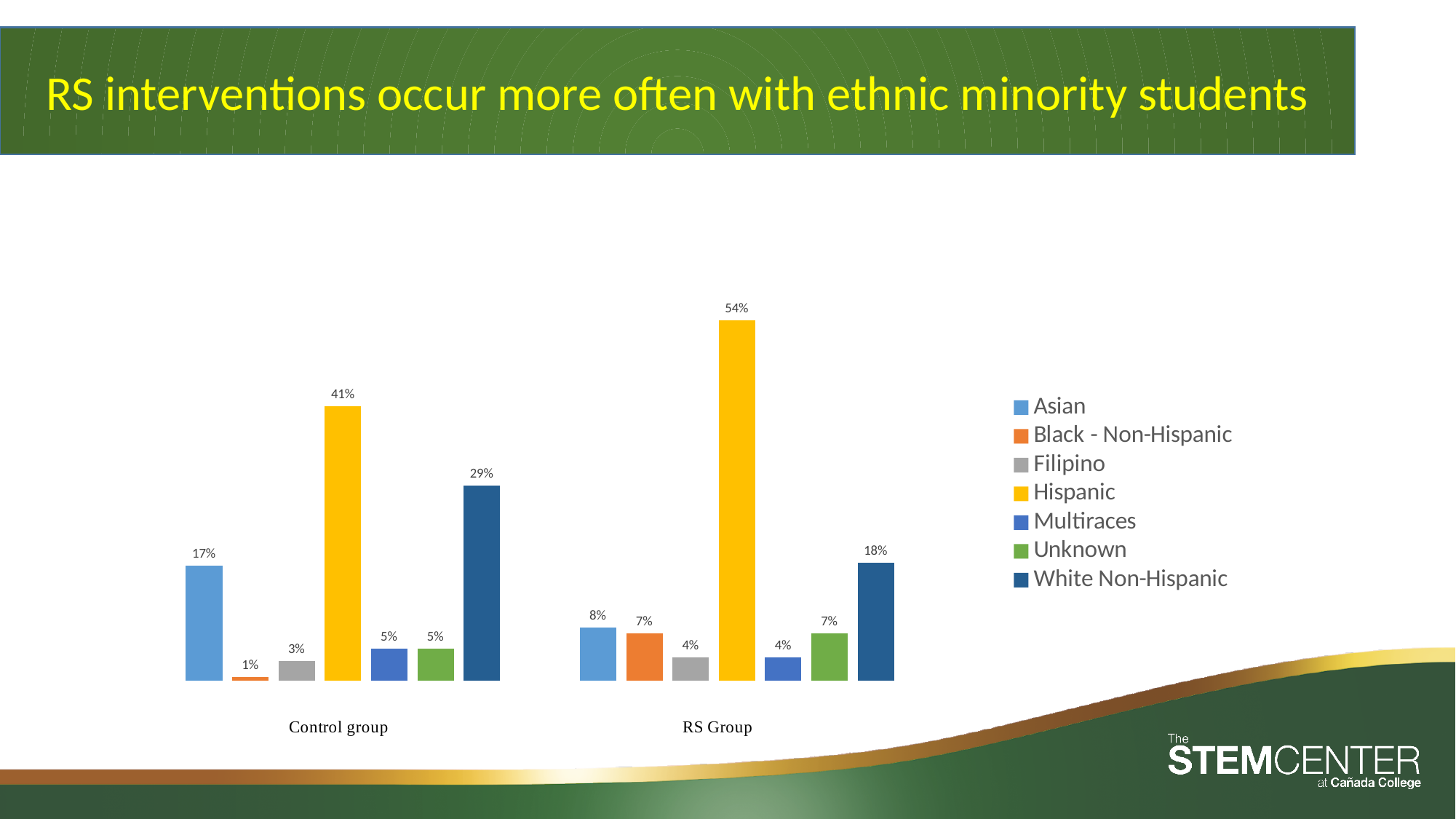
What is the value for White Non-Hispanic in the Control group? 29% Which series has the highest value in the Control group? Hispanic What is the value for Hispanic in the RS Group? 54% Which series has the lowest value in the RS Group? Filipino and Multiraces (both 4%) Which is larger, the Asian value in the Control group or the Asian value in the RS Group? Control group What kind of chart is shown on the slide? Bar chart How many series does the legend list? 7 How many categories are shown on the x axis? 2 What is the value for Black - Non-Hispanic in the Control group? 1% What is the difference between the Hispanic values for the RS Group and the Control group? 13 percentage points What colour represents Hispanic in the chart? Yellow What is the value for Asian in the RS Group? 8%